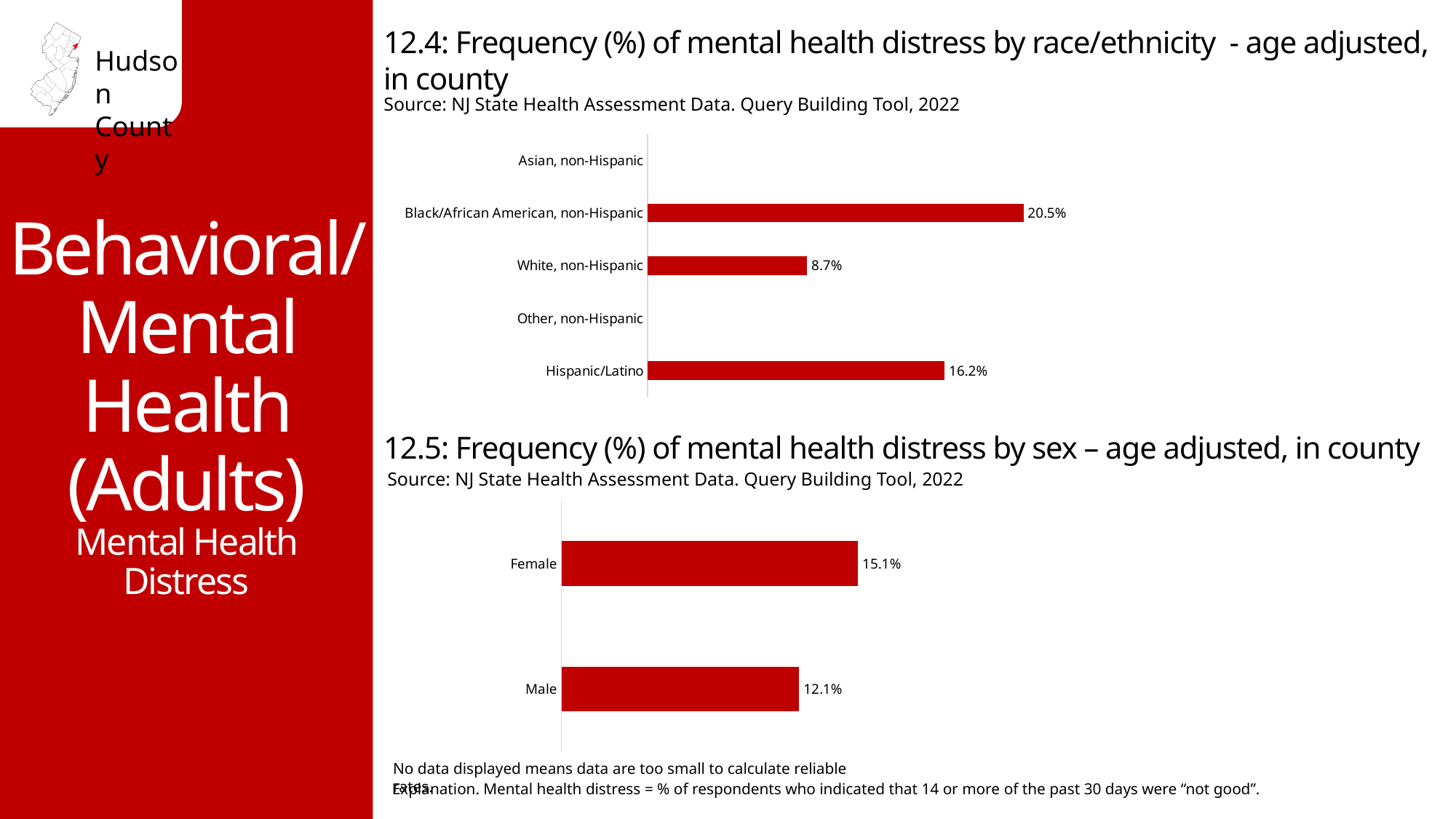
In chart 12.4 (mental health distress by race/ethnicity), what is the value for White, non-Hispanic? 8.7% In chart 12.4 (mental health distress by race/ethnicity), which is larger: the value for Hispanic/Latino or for White, non-Hispanic? Hispanic/Latino In chart 12.5 (mental health distress by sex), what is the value for Female? 15.1% In chart 12.4 (mental health distress by race/ethnicity), what is the difference between the Black/African American, non-Hispanic and White, non-Hispanic values? 11.8% In chart 12.4 (mental health distress by race/ethnicity), how many race/ethnicity categories are listed on the axis? 5 What kind of chart is chart 12.5 (mental health distress by sex)? Bar chart In chart 12.5 (mental health distress by sex), what is the difference between the Female and Male values? 3.0% In chart 12.4 (mental health distress by race/ethnicity), which race/ethnicity group has the highest value? Black/African American, non-Hispanic In chart 12.4 (mental health distress by race/ethnicity), what is the value for Black/African American, non-Hispanic? 20.5% In chart 12.4 (mental health distress by race/ethnicity), what is the value for Hispanic/Latino? 16.2% In chart 12.4 (mental health distress by race/ethnicity), which categories have no bar displayed? Asian, non-Hispanic and Other, non-Hispanic In chart 12.5 (mental health distress by sex), what is the value for Male? 12.1%